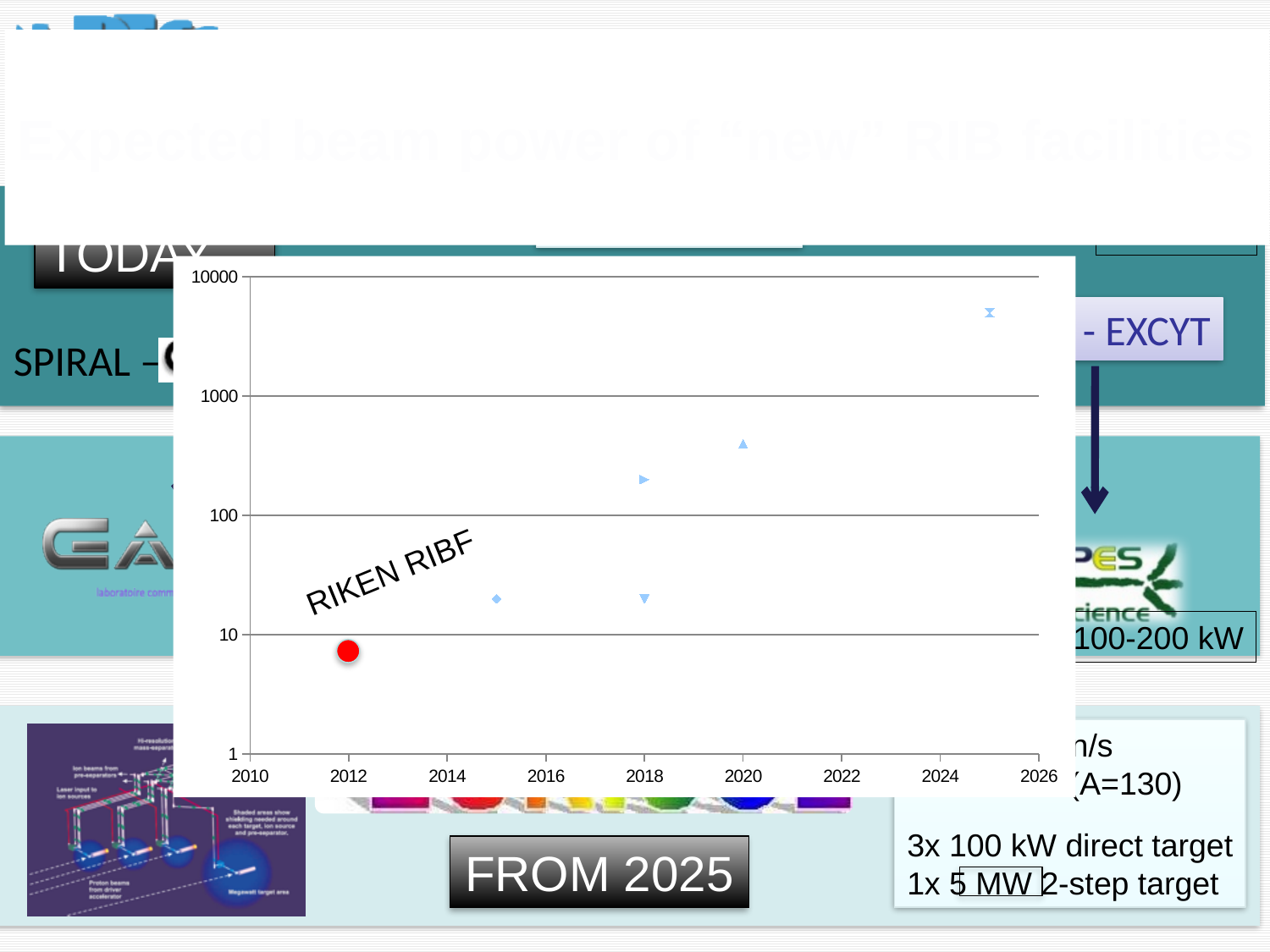
Which has the larger value: the point at 2020 or the point at 2015? the point at 2020 Is the value of the point plotted at 2015 greater or less than 10? greater What kind of chart is shown on the slide? scatter chart What is the highest tick value shown on the y axis? 10000 In which year is the lowest plotted point located? 2012 Is the value of the point plotted at 2020 greater or less than 100? greater Is the value of the red point plotted at 2012 greater or less than 10? less What label is written next to the red point on the chart? RIKEN RIBF In which year is the highest plotted point located? 2025 Do the plotted values generally rise or fall as the year increases along the x axis? rise